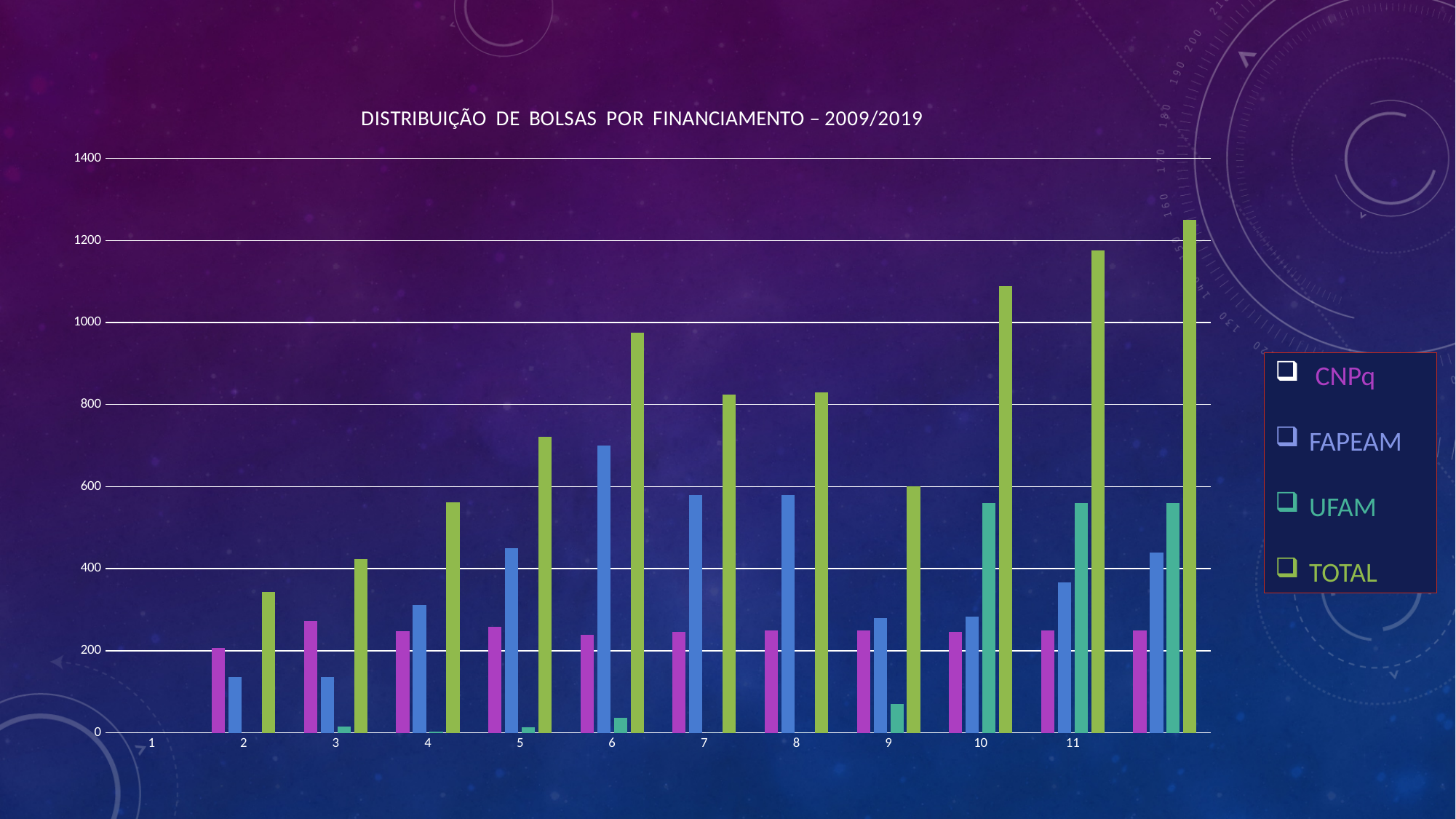
Which series is shown in green bars according to the legend? TOTAL Is the FAPEAM value for category 6 greater or less than 600? greater For category 6, which is larger, the FAPEAM value or the TOTAL value? TOTAL What kind of chart is shown on the slide? bar chart For category 2, which is larger, the CNPq value or the FAPEAM value? CNPq Is the UFAM value for category 10 greater or less than 400? greater Which category has the lowest TOTAL value among the labelled categories 2 to 11? 2 What is the title of the chart? DISTRIBUIÇÃO DE BOLSAS POR FINANCIAMENTO – 2009/2019 How many series does the chart's legend list? 4 Is the CNPq value for category 3 greater or less than 200? greater